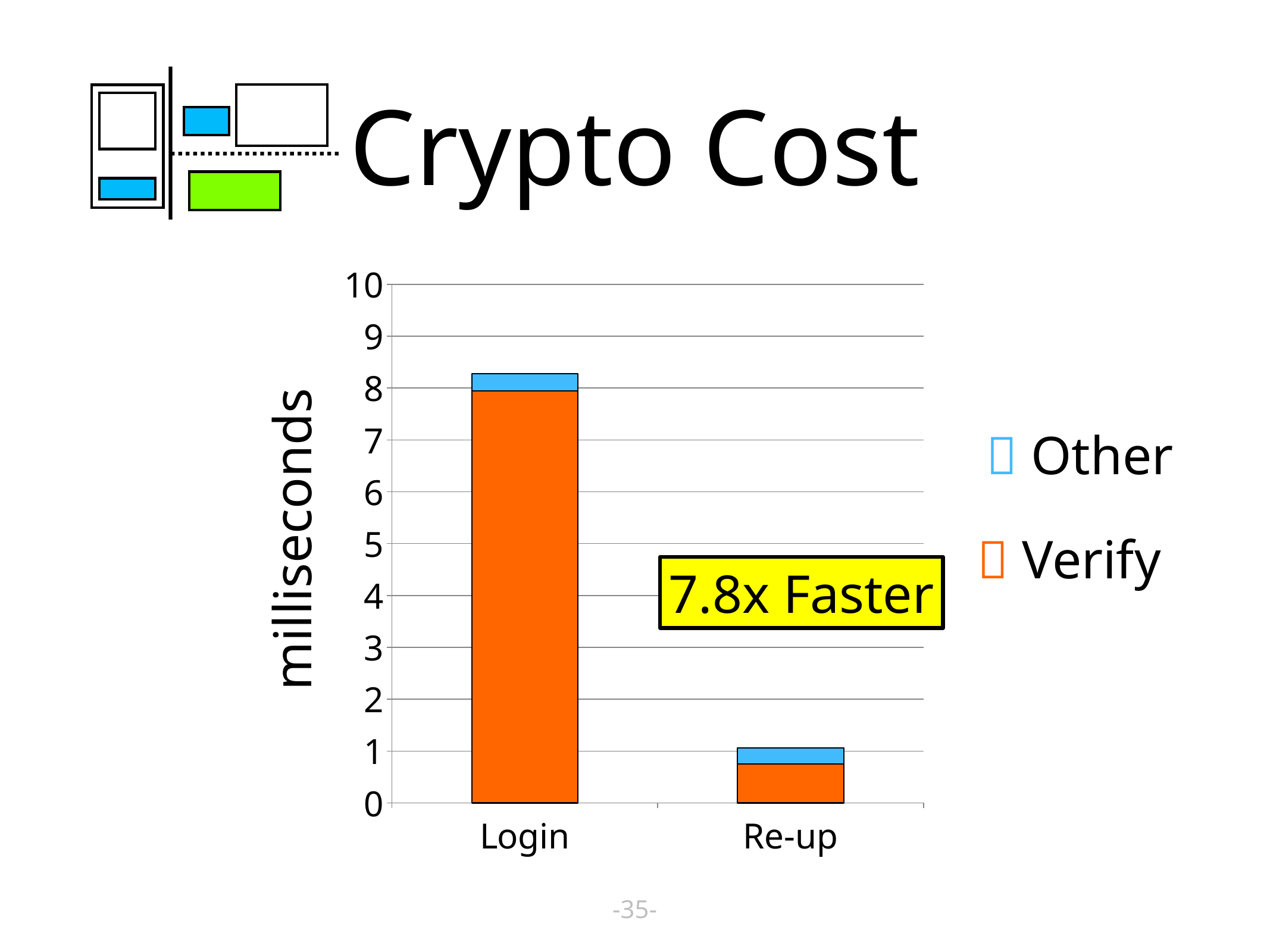
How many series does the chart's legend list? 2 What kind of chart is shown on the slide? Stacked bar chart Is the total bar for Login greater or less than 8? greater What unit is shown on the y axis label of the chart? milliseconds Is the total bar for Re-up greater or less than 2? less Is the Verify portion of the Login bar greater or less than 7? greater Which is larger, the Verify value for Login or the Verify value for Re-up? Login Which category has the shortest stacked bar? Re-up What is the title of the chart on the slide? Crypto Cost Do the bar totals rise or fall from Login to Re-up? fall How many categories are shown on the x axis of the chart? 2 Which category has the tallest stacked bar? Login